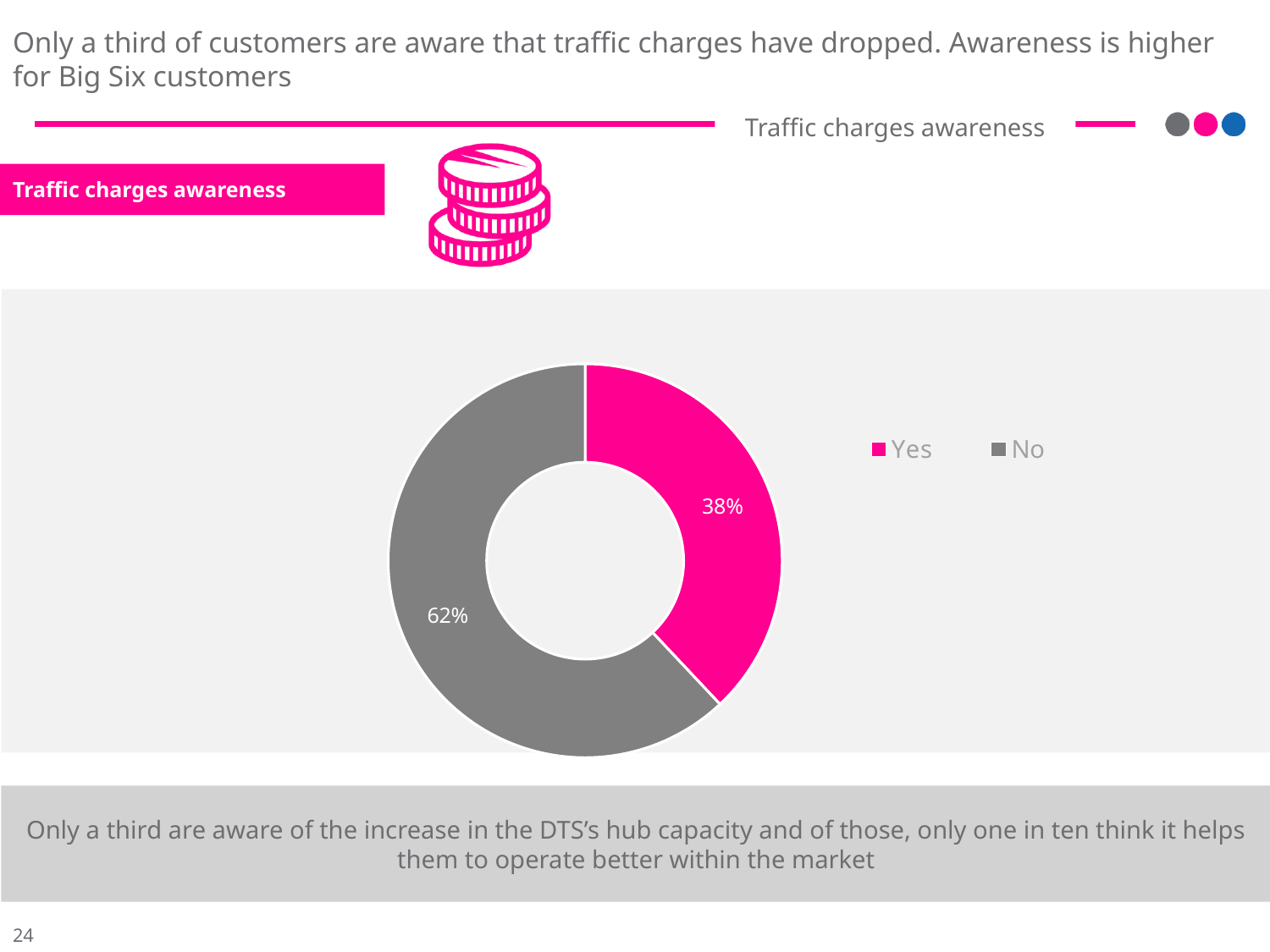
What is the difference in percentage points between the No and Yes shares? 24 Which response has the smaller share in the chart? Yes What is the title of the chart? Traffic charges awareness What share of the chart does the Yes slice represent? 38% Is the share for Yes larger or smaller than the share for No? smaller What percentage of customers answered Yes to being aware of traffic charges? 38% How many categories are shown in the chart? 2 What kind of chart is shown on the slide? Doughnut (pie) chart What percentage of customers answered No in the traffic charges awareness chart? 62% What colour is the Yes slice in the chart? Pink How many entries does the chart legend list? 2 Which response has the larger share in the chart, Yes or No? No